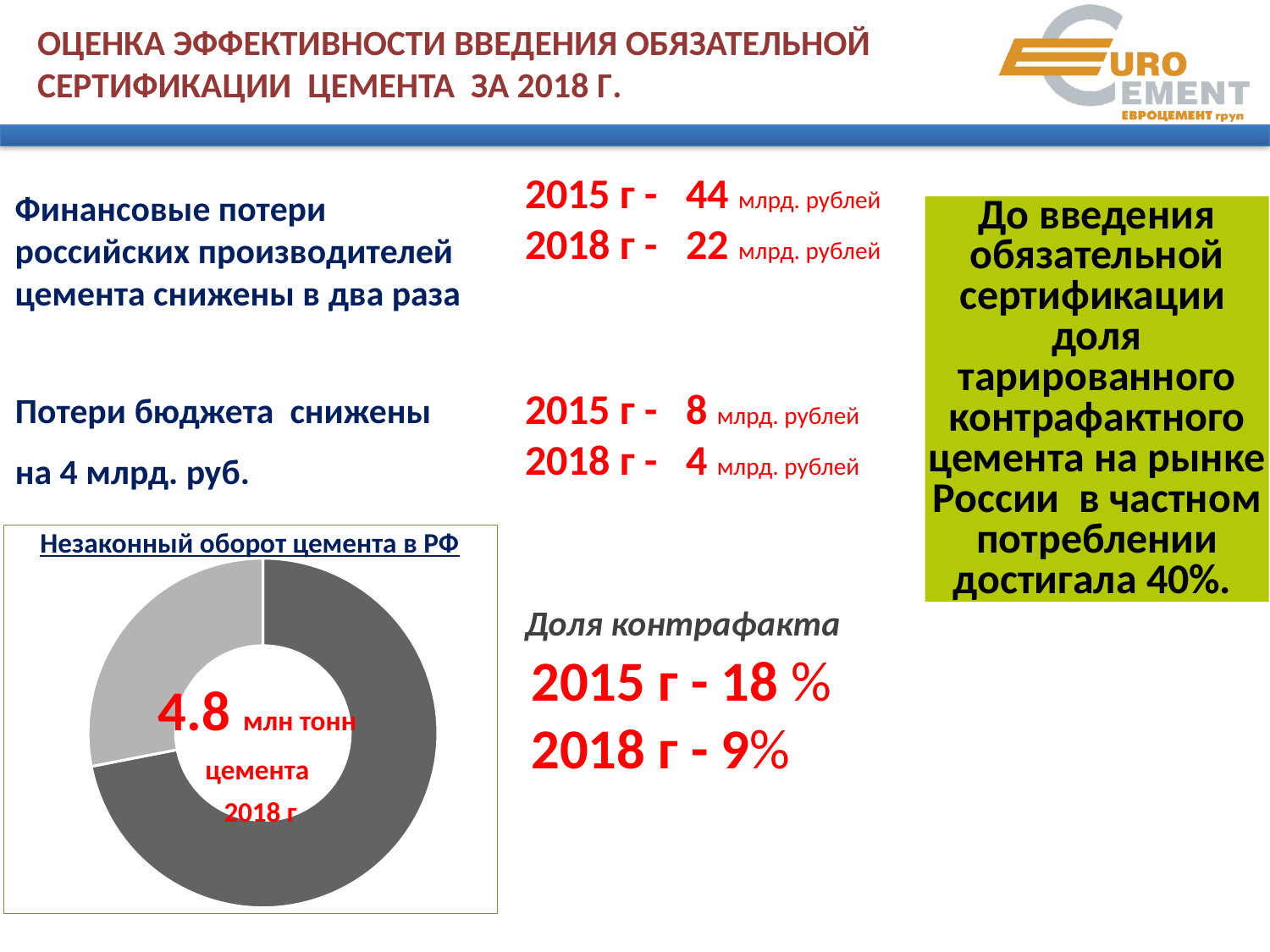
What kind of chart is shown under the title "Незаконный оборот цемента в РФ"? Doughnut (pie) chart How many slices does the doughnut chart "Незаконный оборот цемента в РФ" have? 2 What value is printed in the centre of the doughnut chart "Незаконный оборот цемента в РФ"? 4.8 млн тонн цемента 2018 г What is the title of the doughnut chart on the slide? Незаконный оборот цемента в РФ In the doughnut chart "Незаконный оборот цемента в РФ", which slice is larger, the dark grey one or the light grey one? The dark grey one Does the doughnut chart "Незаконный оборот цемента в РФ" show a legend? No